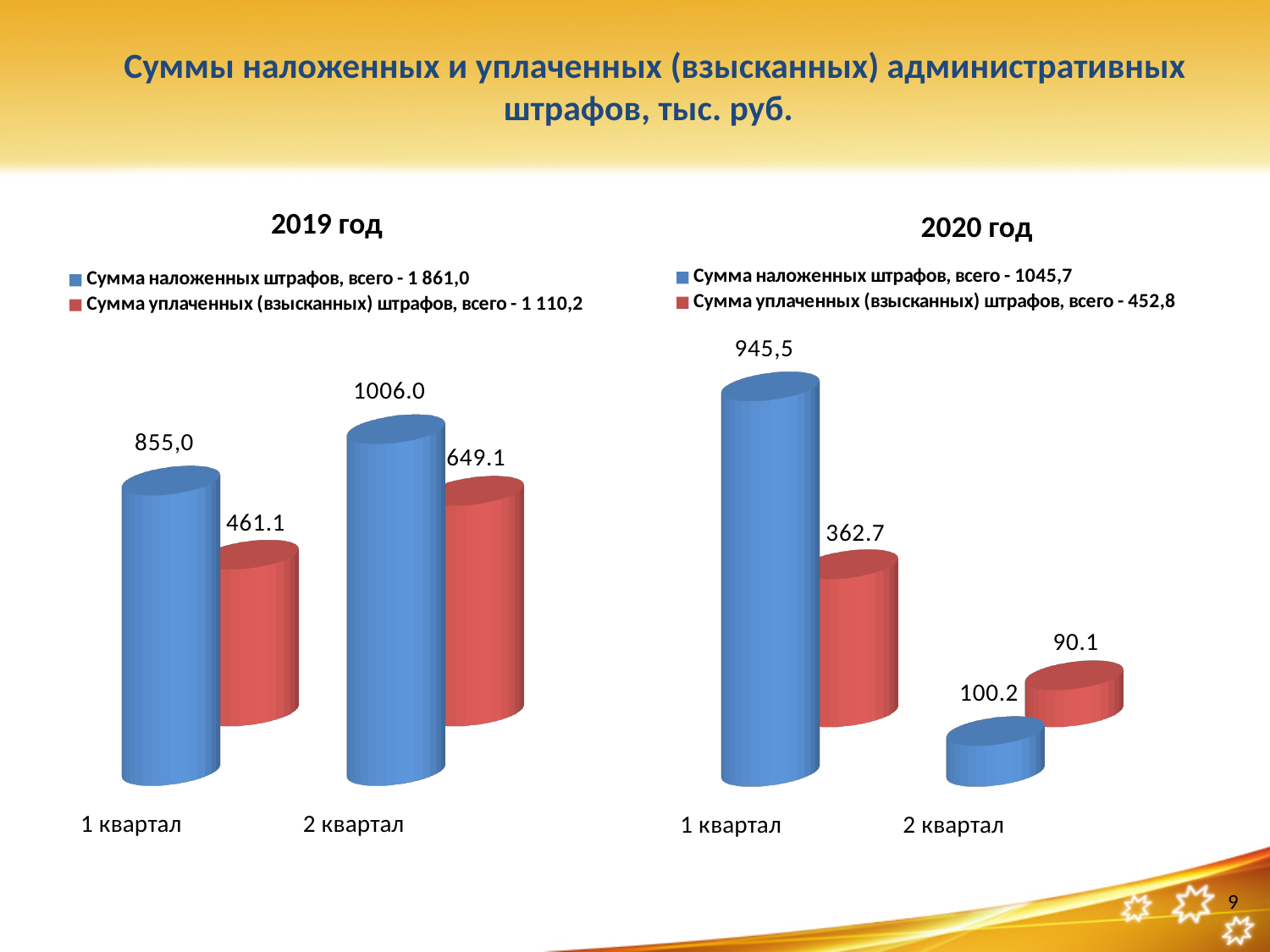
In the 2019 год chart, what is the value of Сумма наложенных штрафов for 1 квартал? 855,0 In the 2020 год chart, which is larger for 2 квартал: Сумма наложенных штрафов or Сумма уплаченных (взысканных) штрафов? Сумма наложенных штрафов What kind of chart is the 2019 год chart? Bar chart In the 2020 год chart, what is the difference between Сумма наложенных штрафов and Сумма уплаченных (взысканных) штрафов for 1 квартал? 582.8 In the 2019 год chart, what is the value of Сумма уплаченных (взысканных) штрафов for 2 квартал? 649.1 How many series does the legend of the 2020 год chart list? 2 In the 2019 год chart, which quarter has the highest value of Сумма наложенных штрафов? 2 квартал In the 2020 год chart, what is the value of Сумма наложенных штрафов for 1 квартал? 945,5 In the 2019 год chart, what is the difference between Сумма наложенных штрафов for 2 квартал and 1 квартал? 151.0 In the 2020 год chart, what is the value of Сумма уплаченных (взысканных) штрафов for 2 квартал? 90.1 In the 2020 год chart, does Сумма наложенных штрафов rise or fall from 1 квартал to 2 квартал? Fall In the 2020 год chart, which quarter has the lowest value of Сумма уплаченных (взысканных) штрафов? 2 квартал